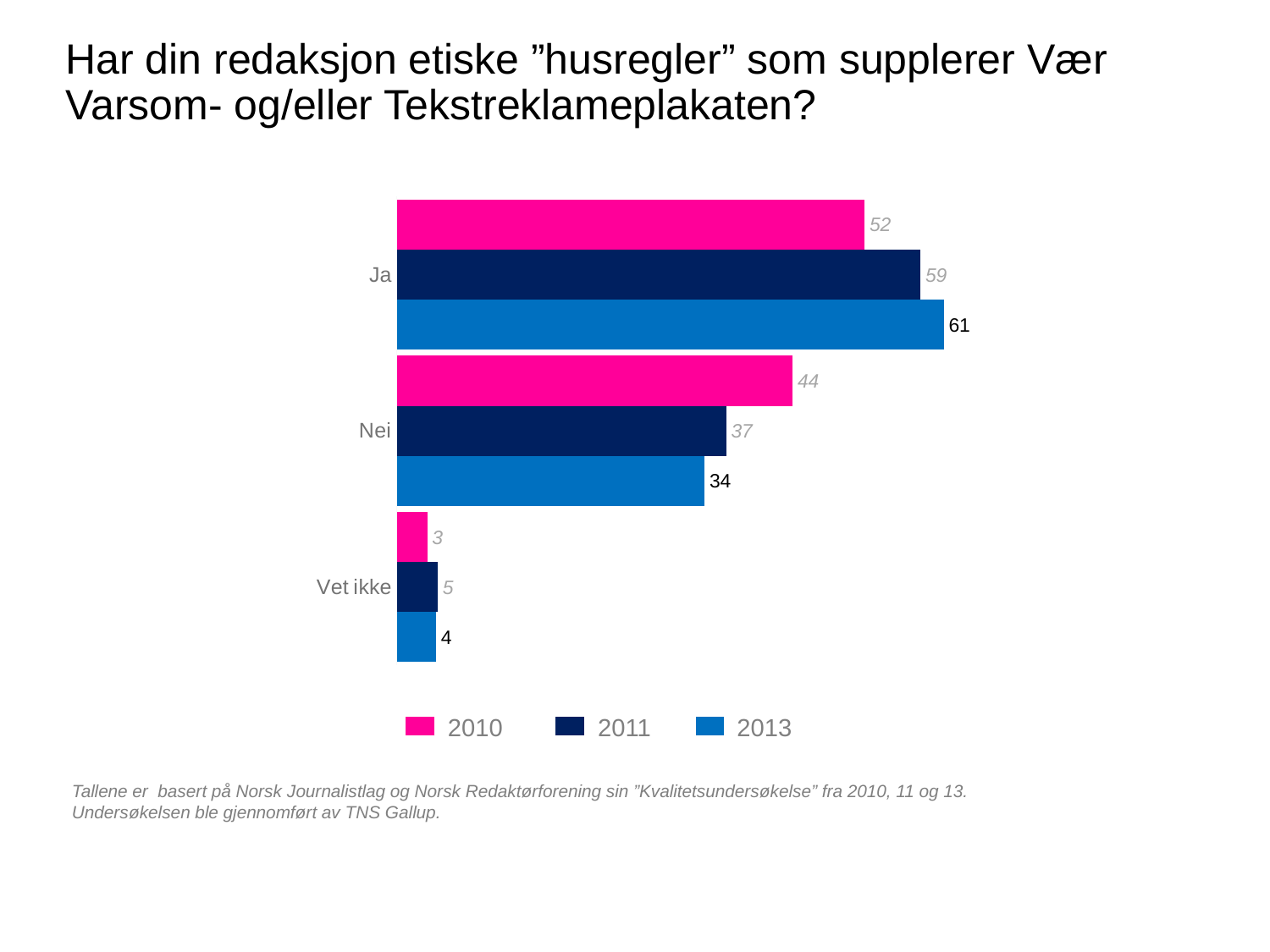
How many series does the legend list? 3 Which category has the highest value in the 2011 series? Ja What is the value for "Ja" in the 2013 series? 61 What kind of chart is shown on the slide? Bar chart What is the difference between the 2013 and 2010 values for "Ja"? 9 Which category has the lowest value in the 2010 series? Vet ikke What is the value for "Vet ikke" in the 2011 series? 5 What is the value for "Nei" in the 2010 series? 44 How many categories are shown on the chart? 3 What is the difference between the 2010 and 2013 values for "Nei"? 10 Which is larger: the 2011 value for "Ja" or the 2011 value for "Nei"? Ja Which series is shown in pink in the legend? 2010